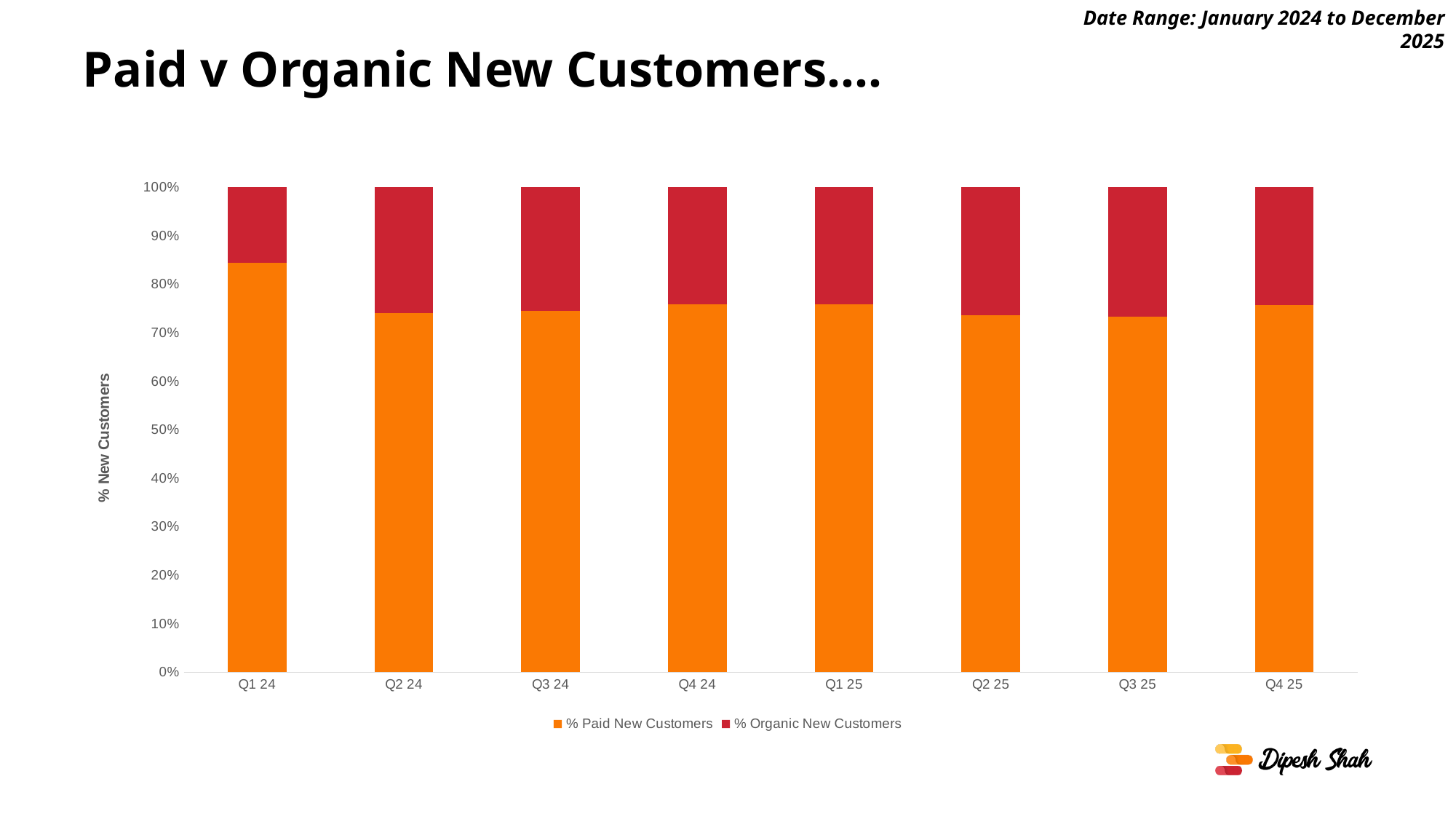
Which is larger, the % Paid New Customers share in Q1 24 or in Q2 24? Q1 24 Is the value for % Paid New Customers in Q3 25 greater or less than 70%? greater What is the title of the chart on the slide? Paid v Organic New Customers.... How many series does the chart's legend list? 2 Which quarter has the highest share of % Paid New Customers? Q1 24 What is the label on the y axis of the chart? % New Customers Is the value for % Paid New Customers in Q2 24 greater or less than 80%? less What kind of chart is shown on the slide? stacked bar chart How many quarters are shown on the x axis of the chart? 8 What is the total of the stacked bar for Q4 25? 100% Is the value for % Paid New Customers in Q1 24 greater or less than 80%? greater Which quarter has the lowest share of % Organic New Customers? Q1 24